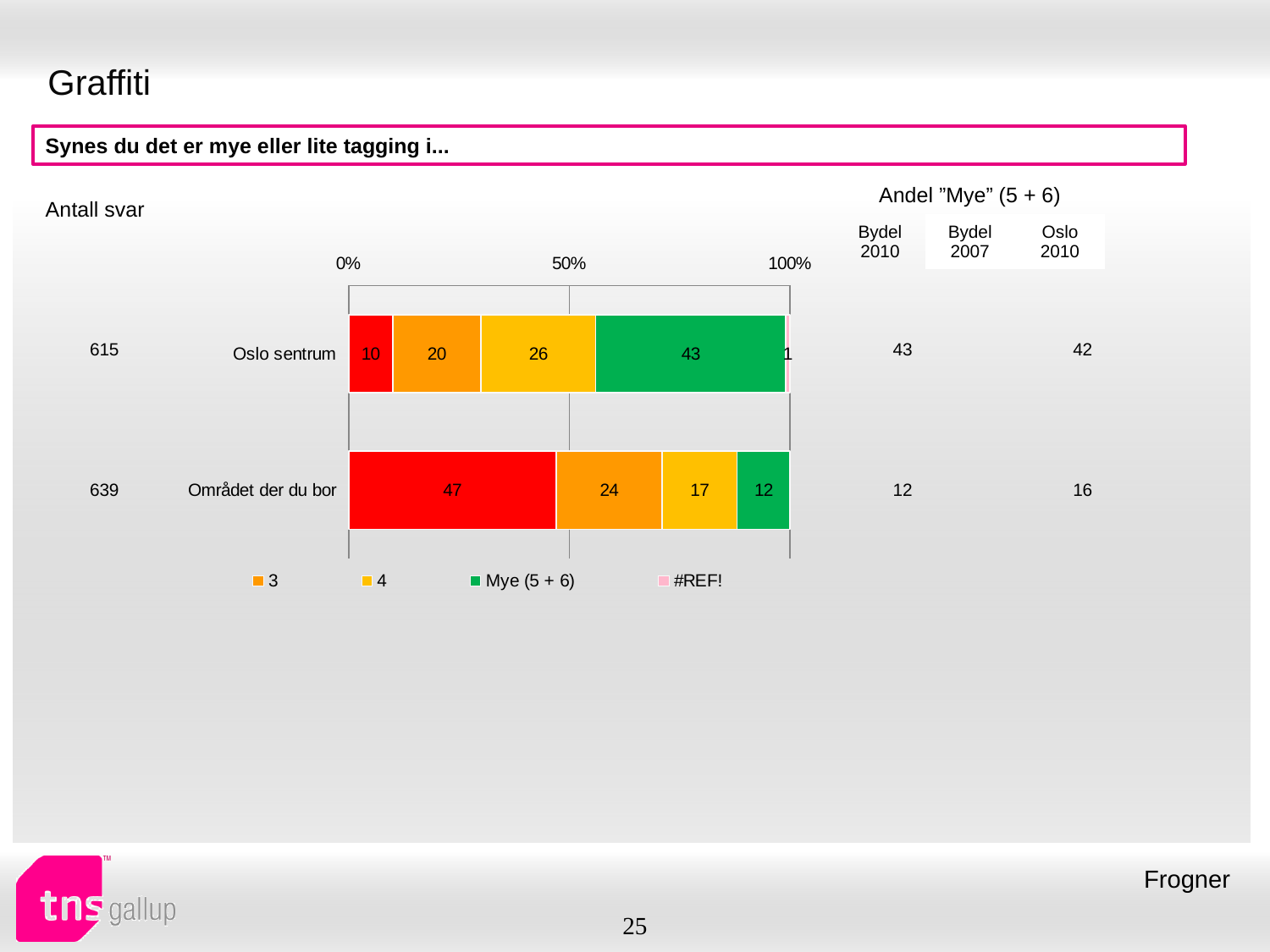
How many categories are plotted in the chart? 2 What is the 'Antall svar' (number of responses) shown for Området der du bor? 639 What is the value of the '4' segment for Oslo sentrum? 26 What is the value of the Mye (5 + 6) segment for Området der du bor? 12 What is the value of the Mye (5 + 6) segment for Oslo sentrum? 43 What is the difference between the '3' segment values for Området der du bor and Oslo sentrum? 4 What is the difference between the Mye (5 + 6) values for Oslo sentrum and Området der du bor? 31 What kind of chart is shown on the slide? bar chart Which category has the larger Mye (5 + 6) value, Oslo sentrum or Området der du bor? Oslo sentrum How many entries does the chart legend list? 4 What is the value of the '4' segment for Området der du bor? 17 What is the value of the '3' segment for Oslo sentrum? 20